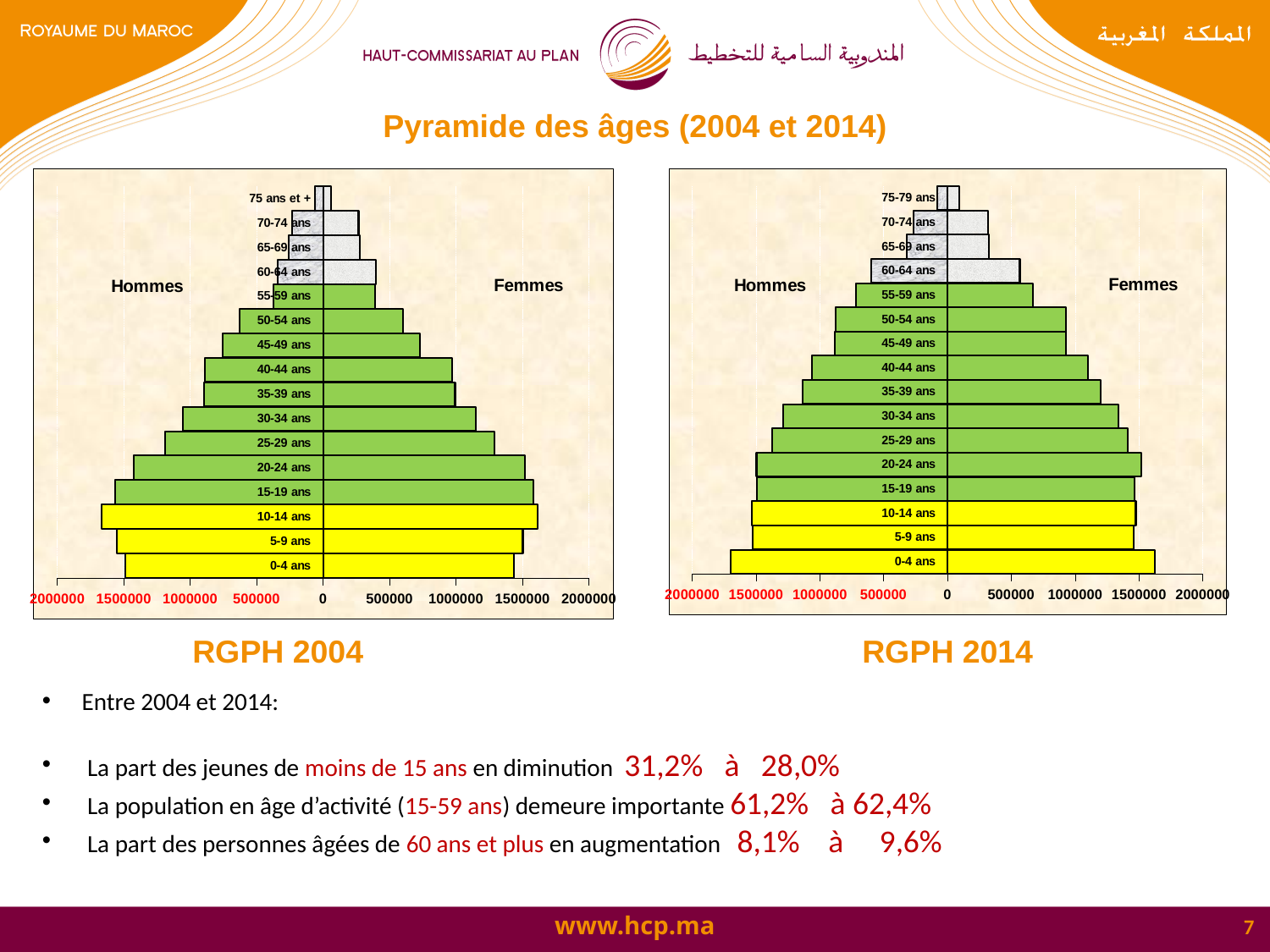
What kind of chart is the RGPH 2004 chart? bar chart On the RGPH 2004 chart, which age group has the widest bars? 10-14 ans On the RGPH 2004 chart, which is larger for Hommes: 10-14 ans or 60-64 ans? 10-14 ans On the RGPH 2014 chart, which age group has the narrowest bars? 75-79 ans On the RGPH 2004 chart, which age group has the narrowest bars? 75 ans et + On the RGPH 2004 chart, is the Femmes value for 75 ans et + greater or less than 500000? less On the RGPH 2004 chart, is the Hommes value for 10-14 ans greater or less than 1500000? greater On the RGPH 2014 chart, is the Hommes value for 55-59 ans greater or less than 1000000? less On the RGPH 2004 chart, what colour are the bars for the 0-4, 5-9 and 10-14 ans age groups? yellow How many age groups are shown on the RGPH 2014 chart? 16 How many age groups are shown on the RGPH 2004 chart? 16